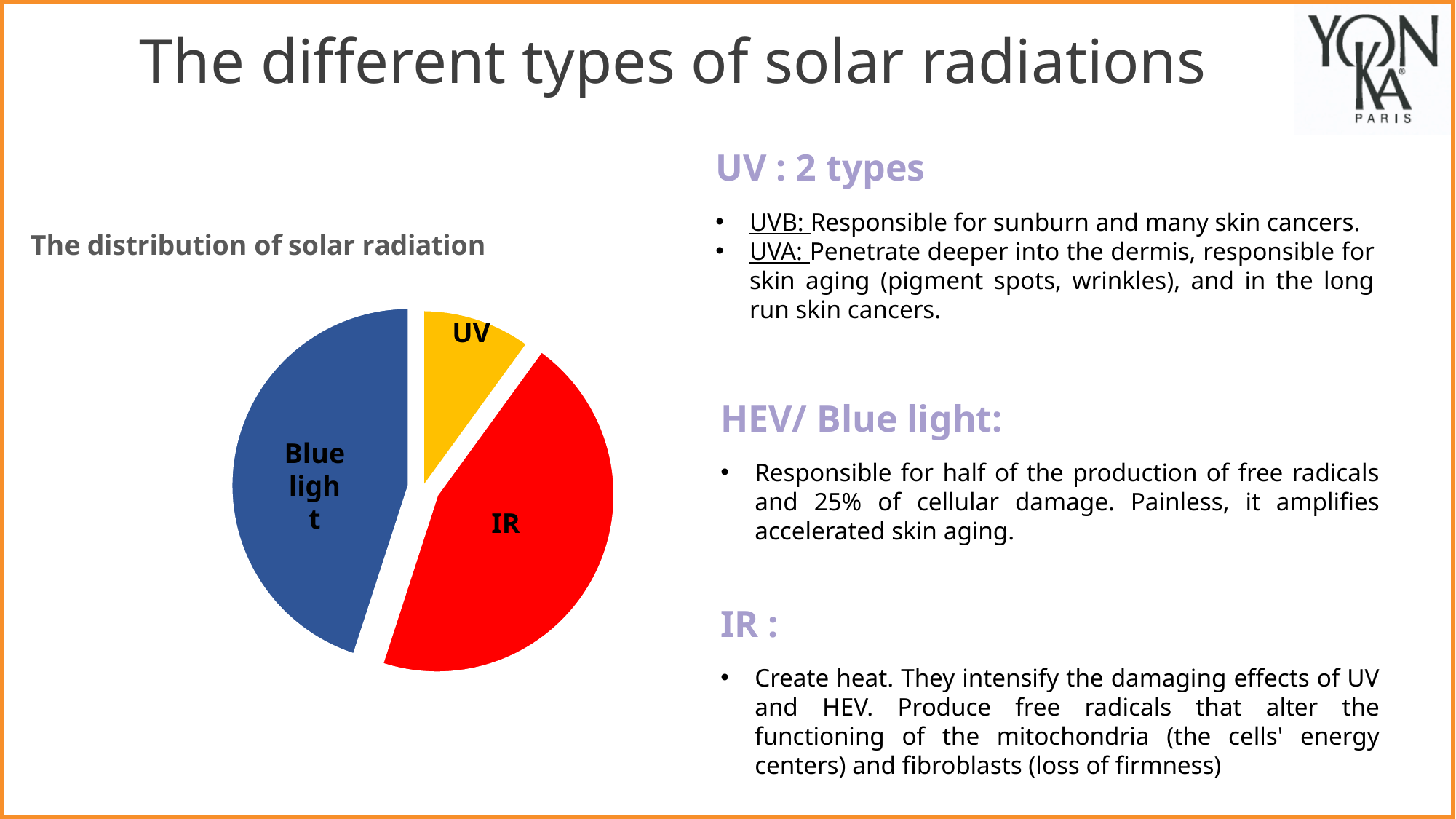
Which categories are labelled on the pie chart? Blue light, IR, UV What kind of chart is shown on the slide? pie chart Which type of solar radiation has the smallest slice in the pie chart? UV Which slice is larger in the pie chart, UV or IR? IR Which slice is larger in the pie chart, UV or Blue light? Blue light What colour is the IR slice in the pie chart? red What is the title of the pie chart? The distribution of solar radiation How many slices does the pie chart have? 3